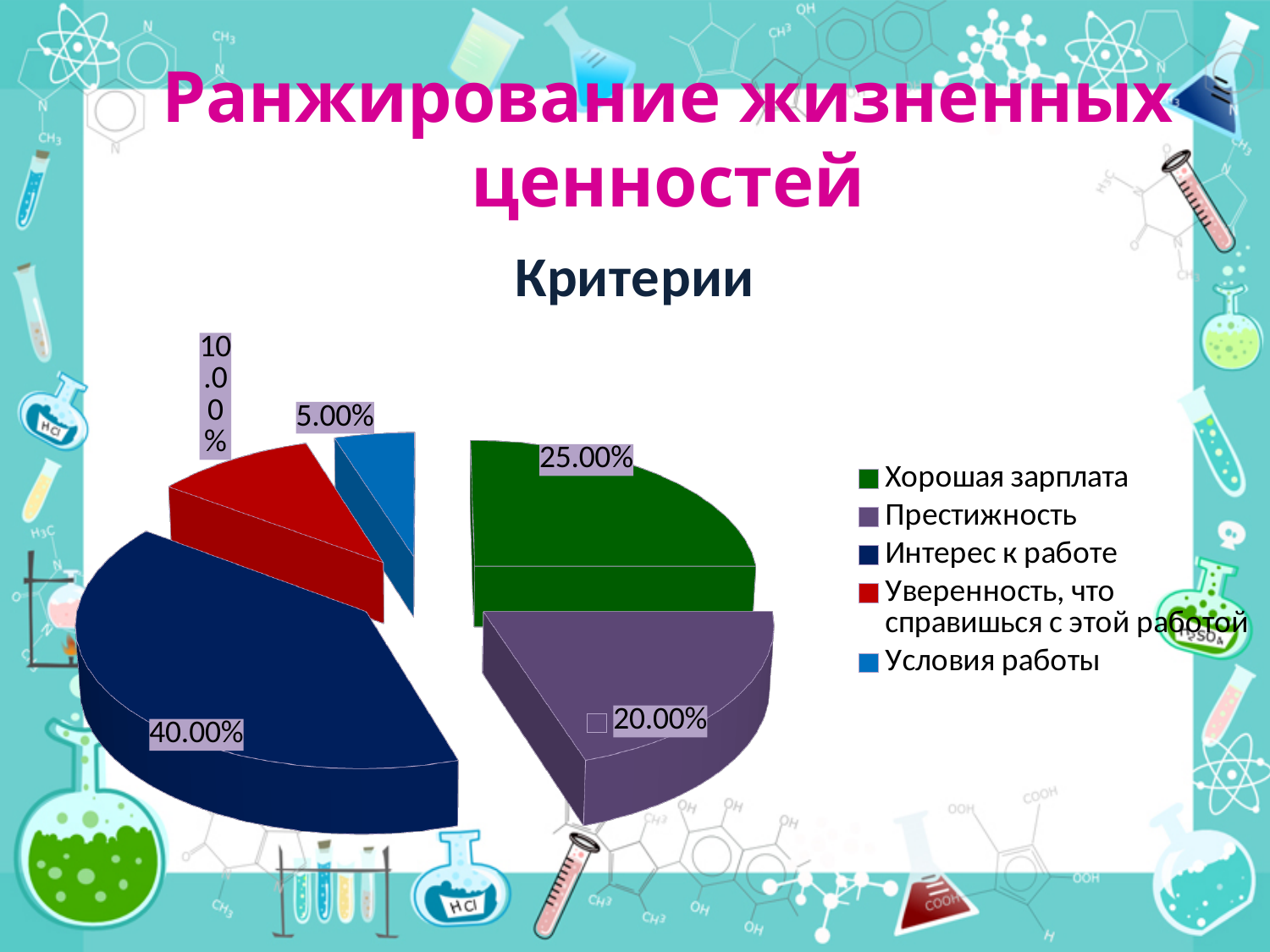
Which category has the largest share of the pie? Интерес к работе What is the value for Интерес к работе? 40.00% Which category has the smallest share of the pie? Условия работы What is the difference between the values for Интерес к работе and Хорошая зарплата? 15.00% What is the value for Престижность? 20.00% How many slices does the pie chart have? 5 What is the value for Хорошая зарплата? 25.00% Which colour represents Хорошая зарплата in the legend? green Which is larger, the value for Престижность or the value for Уверенность, что справишься с этой работой? Престижность What kind of chart is shown on the slide? pie chart What is the value for Условия работы? 5.00% What is the title of the chart? Критерии